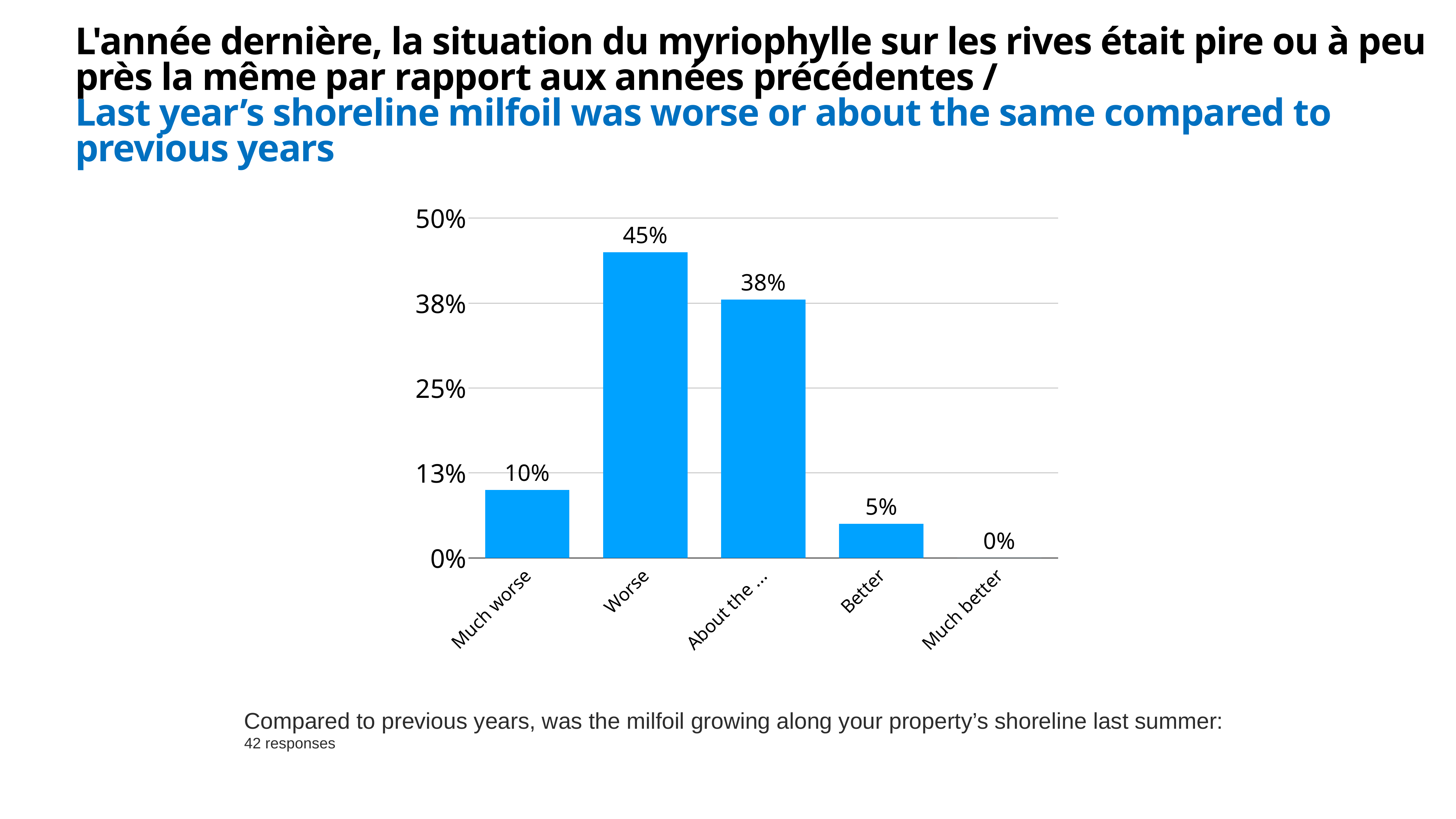
Which category has the highest value? Worse Is the value for "Worse" greater or less than 38%? greater What percentage is shown for "Better"? 5% What kind of chart is shown on the slide? Bar chart What is the difference between the values for "Worse" and "Much worse"? 35% Which is larger, the value for "Much worse" or the value for "Better"? Much worse What percentage of respondents said the milfoil was "Worse"? 45% How many responses does the chart note say it is based on? 42 responses What is the value for "Much better"? 0% What is the value shown for "Much worse"? 10% Which category has the lowest value? Much better How many categories are shown on the x axis? 5